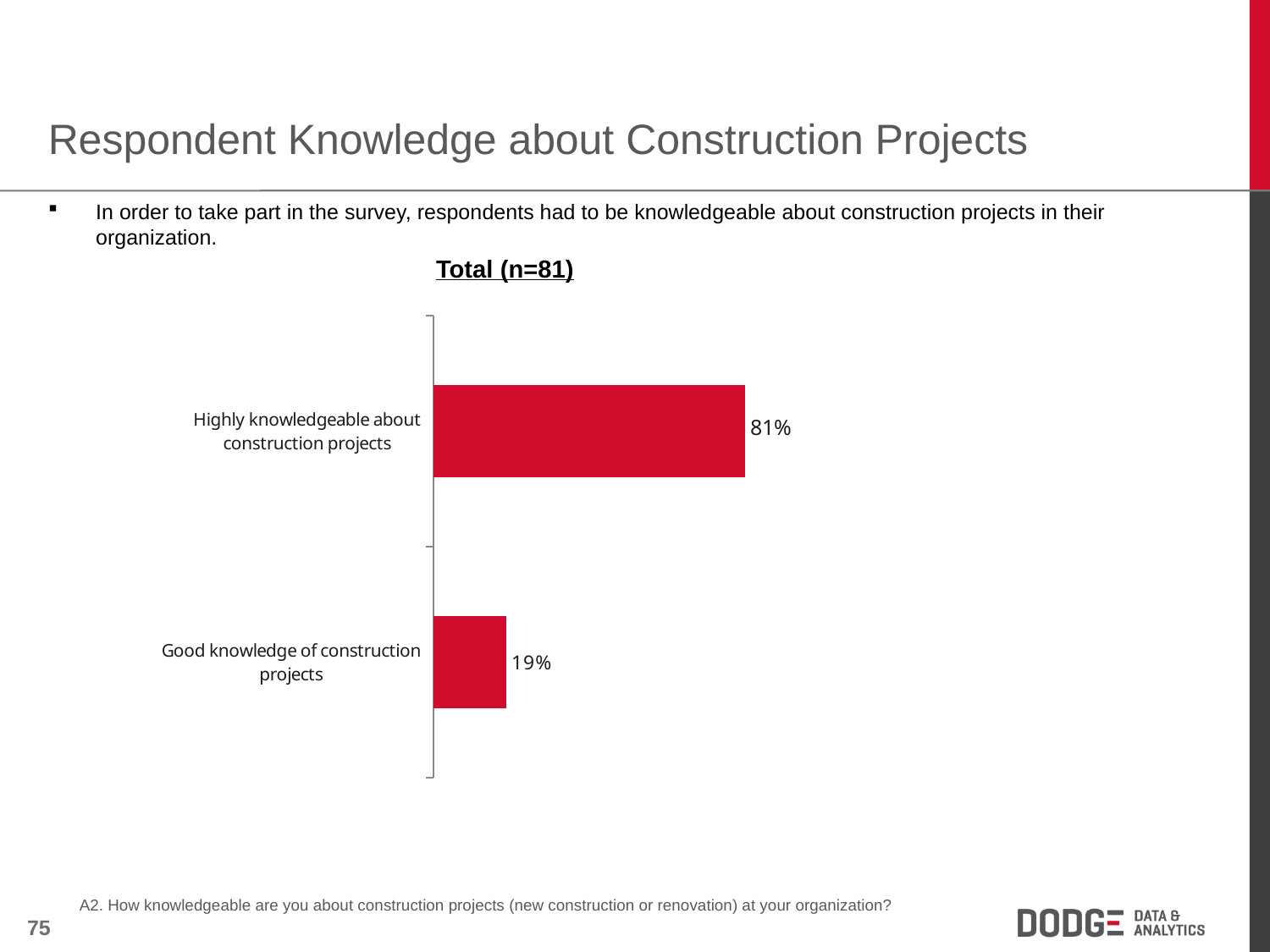
What percentage of respondents have good knowledge of construction projects? 19% What colour are the bars in the chart? Red Which category has the lowest value? Good knowledge of construction projects What is the title of the chart? Total (n=81) What kind of chart is shown on the slide? Bar chart How many categories are shown in the chart? 2 What is the total of the two percentages shown in the chart? 100% Which category has the highest value? Highly knowledgeable about construction projects Which is larger: the share of respondents who are highly knowledgeable or the share with good knowledge of construction projects? Highly knowledgeable about construction projects What percentage of respondents are highly knowledgeable about construction projects? 81% What is the difference between the share of respondents who are highly knowledgeable and those with good knowledge of construction projects? 62%